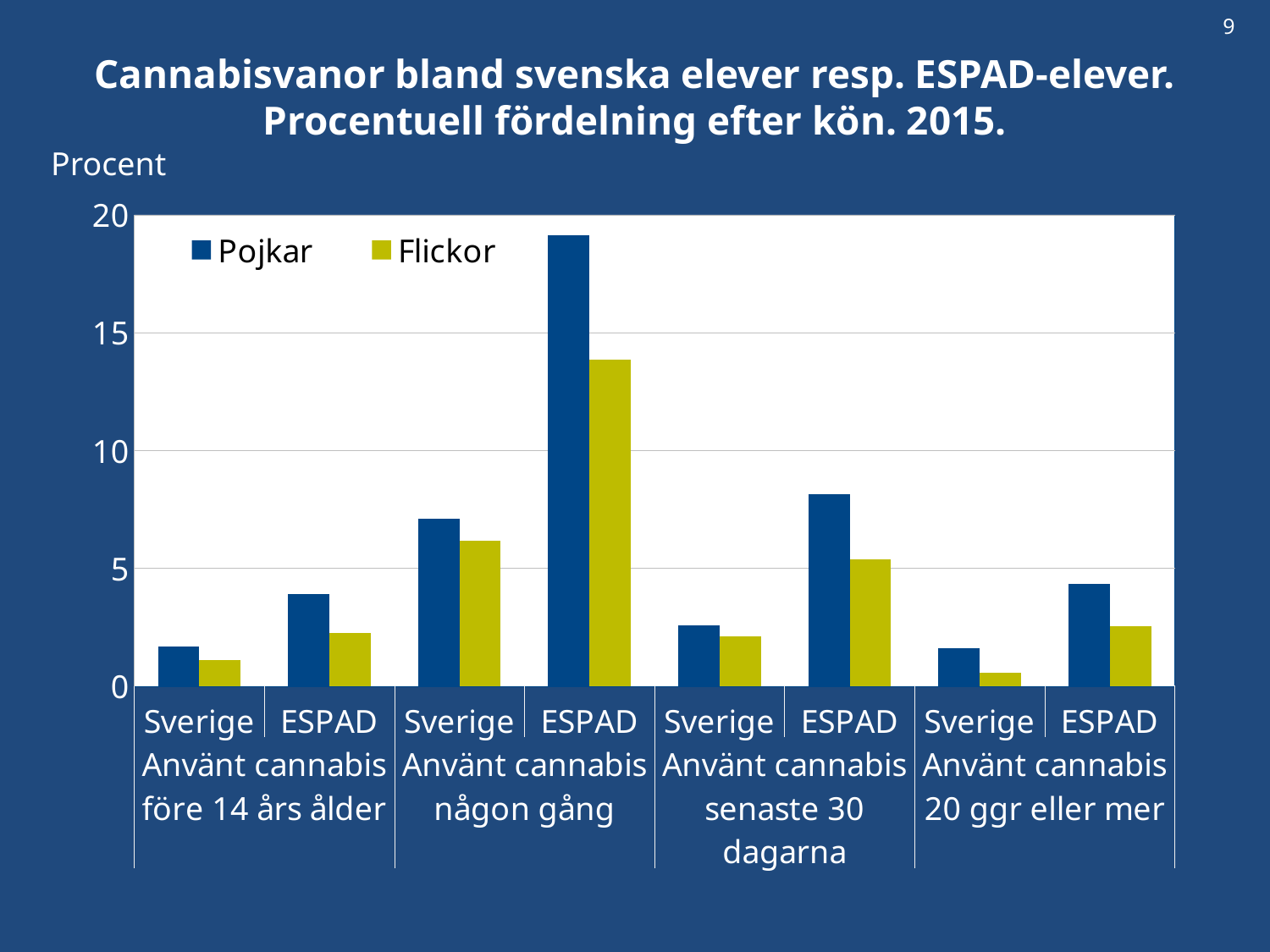
How many series does the legend list? 2 For which category is the Pojkar bar highest? ESPAD, Använt cannabis någon gång Which is larger: the Pojkar value for Sverige, Använt cannabis någon gång, or the Flickor value for ESPAD, Använt cannabis före 14 års ålder? Pojkar value for Sverige, Använt cannabis någon gång What kind of chart is shown on the slide? Bar chart Is the Pojkar value for ESPAD, Använt cannabis senaste 30 dagarna greater or less than 5? greater Is the Flickor value for ESPAD, Använt cannabis någon gång greater or less than 15? less For which category is the Flickor bar lowest? Sverige, Använt cannabis 20 ggr eller mer Is the Flickor value for Sverige, Använt cannabis någon gång greater or less than 5? greater What label is shown above the y axis? Procent For ESPAD, Använt cannabis senaste 30 dagarna, which is larger: Pojkar or Flickor? Pojkar How many category groups (Sverige/ESPAD pairs) are shown along the x axis? 4